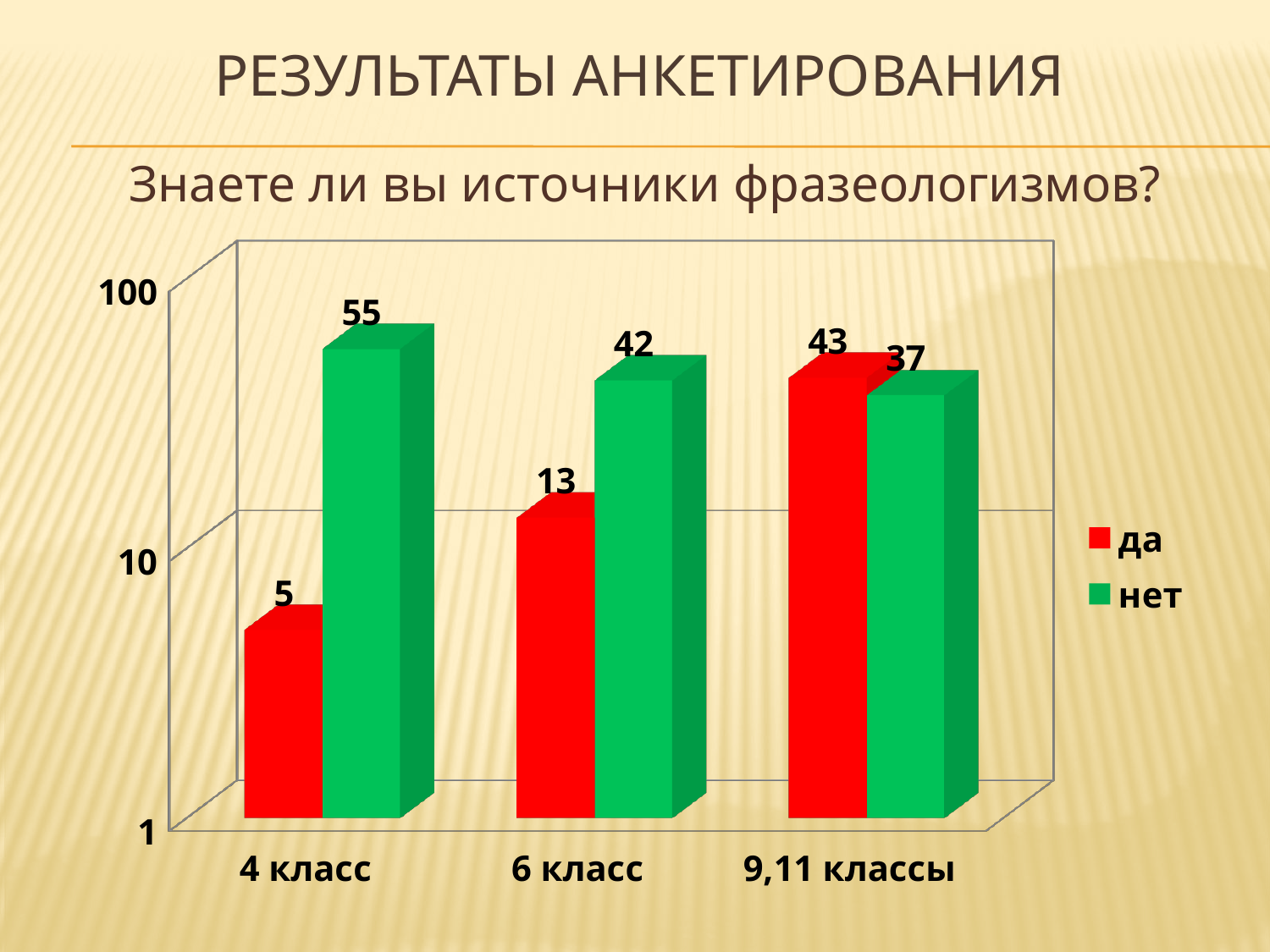
What is the value for "да" in the "4 класс" category? 5 Do the values for "да" rise or fall from "4 класс" to "9,11 классы"? rise What kind of chart is shown on the slide? bar chart What is the value for "нет" in the "6 класс" category? 42 Which category has the lowest value for "да"? 4 класс How many categories are shown on the x axis? 3 What is the difference between the "нет" and "да" values for "4 класс"? 50 How many series does the legend list? 2 What is the value for "да" in the "9,11 классы" category? 43 Which category has the highest value for "нет"? 4 класс Which is larger for "6 класс": "да" or "нет"? нет What is the value for "нет" in the "9,11 классы" category? 37